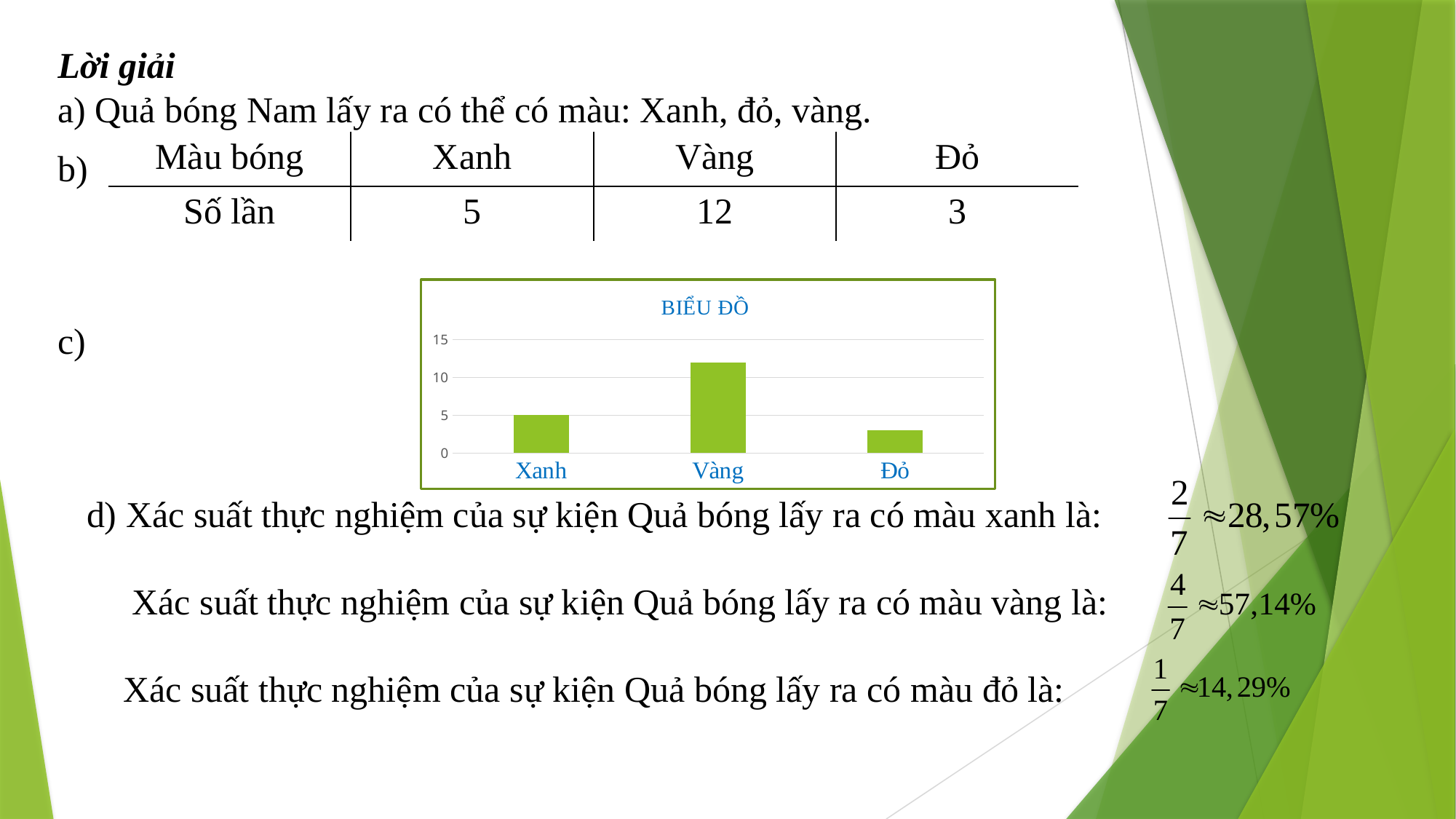
Which category has the lowest bar in the chart? Đỏ Is the value for Vàng greater or less than 10? greater Which is larger, the bar for Xanh or the bar for Đỏ? Xanh Which category has the highest bar in the chart? Vàng How many categories are shown on the x axis of the chart? 3 What is the difference between the values for Vàng and Xanh? 7 What is the value of the bar for Đỏ? 3 What is the value of the bar for Xanh? 5 What kind of chart is shown on the slide? bar chart What is the value of the bar for Vàng? 12 What is the title of the chart? BIỂU ĐỒ Is the value for Đỏ greater or less than 5? less